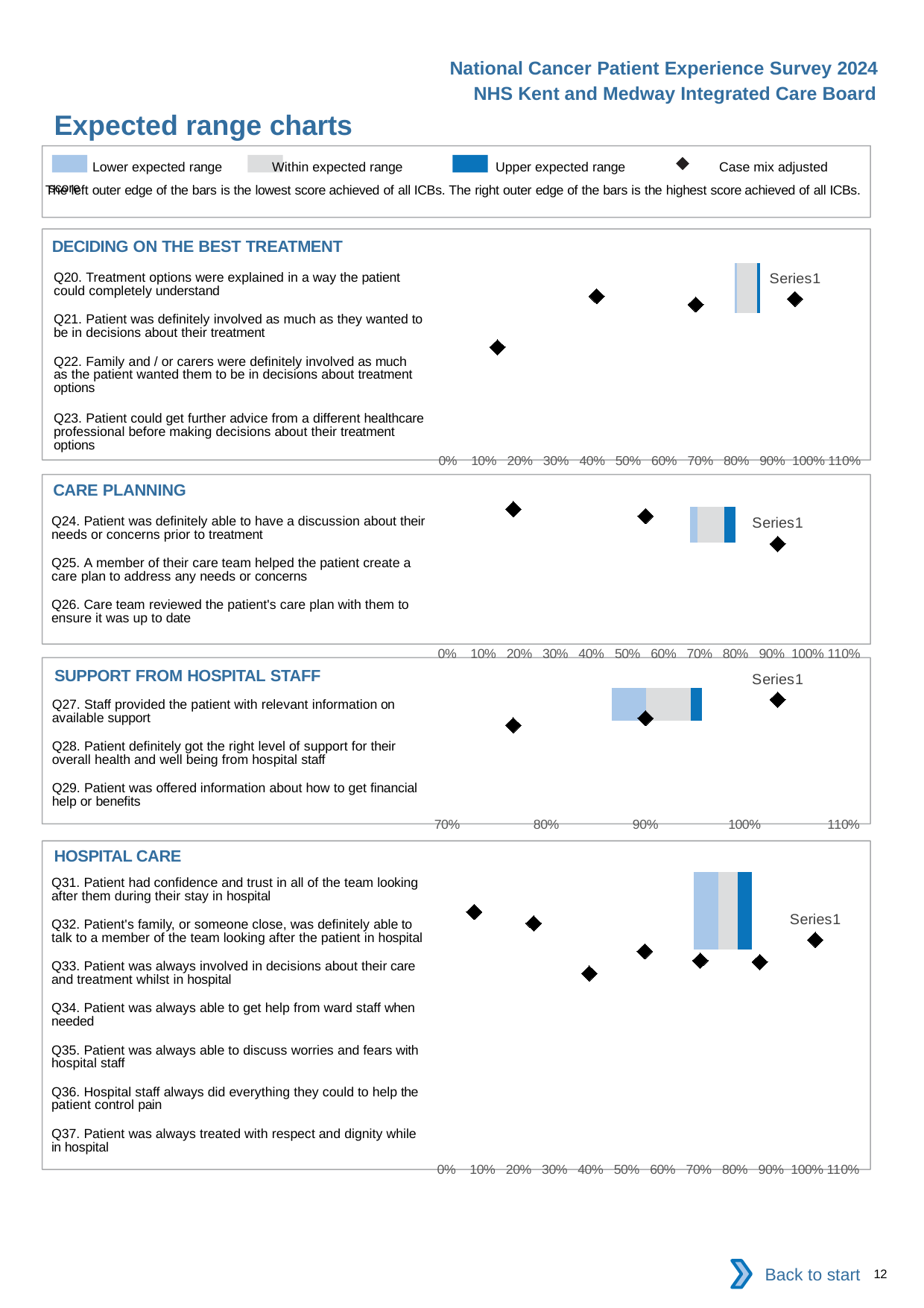
How many charts are shown on the slide? 4 In the SUPPORT FROM HOSPITAL STAFF chart, is the value of the rightmost diamond marker greater or less than 100%? greater What is the title of the first chart on the slide? DECIDING ON THE BEST TREATMENT In the HOSPITAL CARE chart, what is the name of the series shown in the legend? Series1 In the CARE PLANNING chart, is the value of the leftmost diamond marker greater or less than 30%? less In the HOSPITAL CARE chart, is the value of the leftmost diamond marker greater or less than 20%? less In the CARE PLANNING chart, how many diamond markers are plotted? 3 In the HOSPITAL CARE chart, how many diamond markers are plotted? 7 In the DECIDING ON THE BEST TREATMENT chart, how many series does the legend list? 1